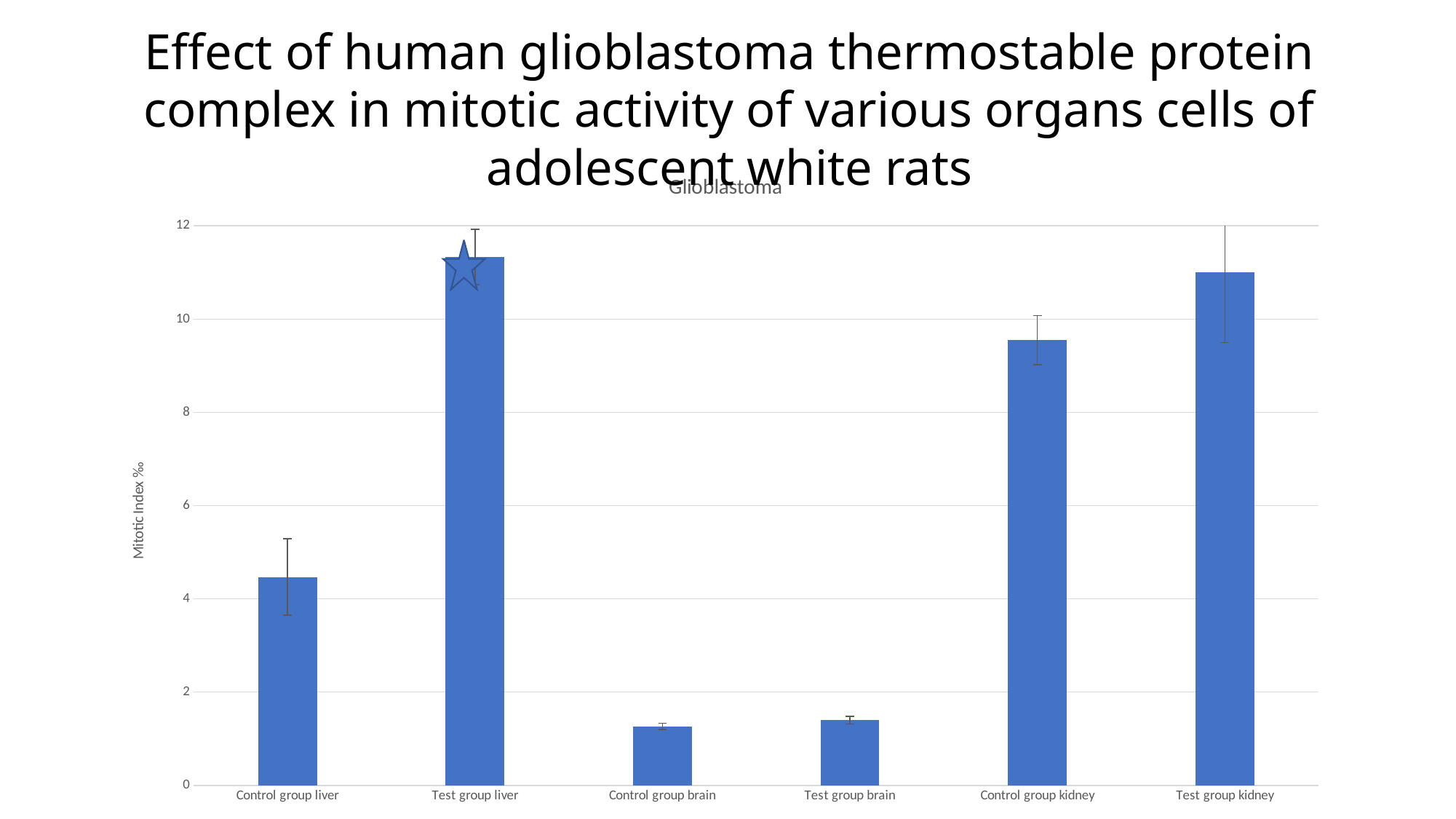
Which is larger, the value for Control group kidney or Test group kidney? Test group kidney How many categories are plotted on the chart? 6 Is the value for Control group liver greater or less than 4? greater Is the value for Test group brain greater or less than 2? less What is the title of the chart? Glioblastoma Is the value for Control group kidney greater or less than 8? greater Which is larger, the value for Control group liver or Test group liver? Test group liver What is the label of the vertical axis? Mitotic Index ‰ What kind of chart is shown on the slide? Bar chart